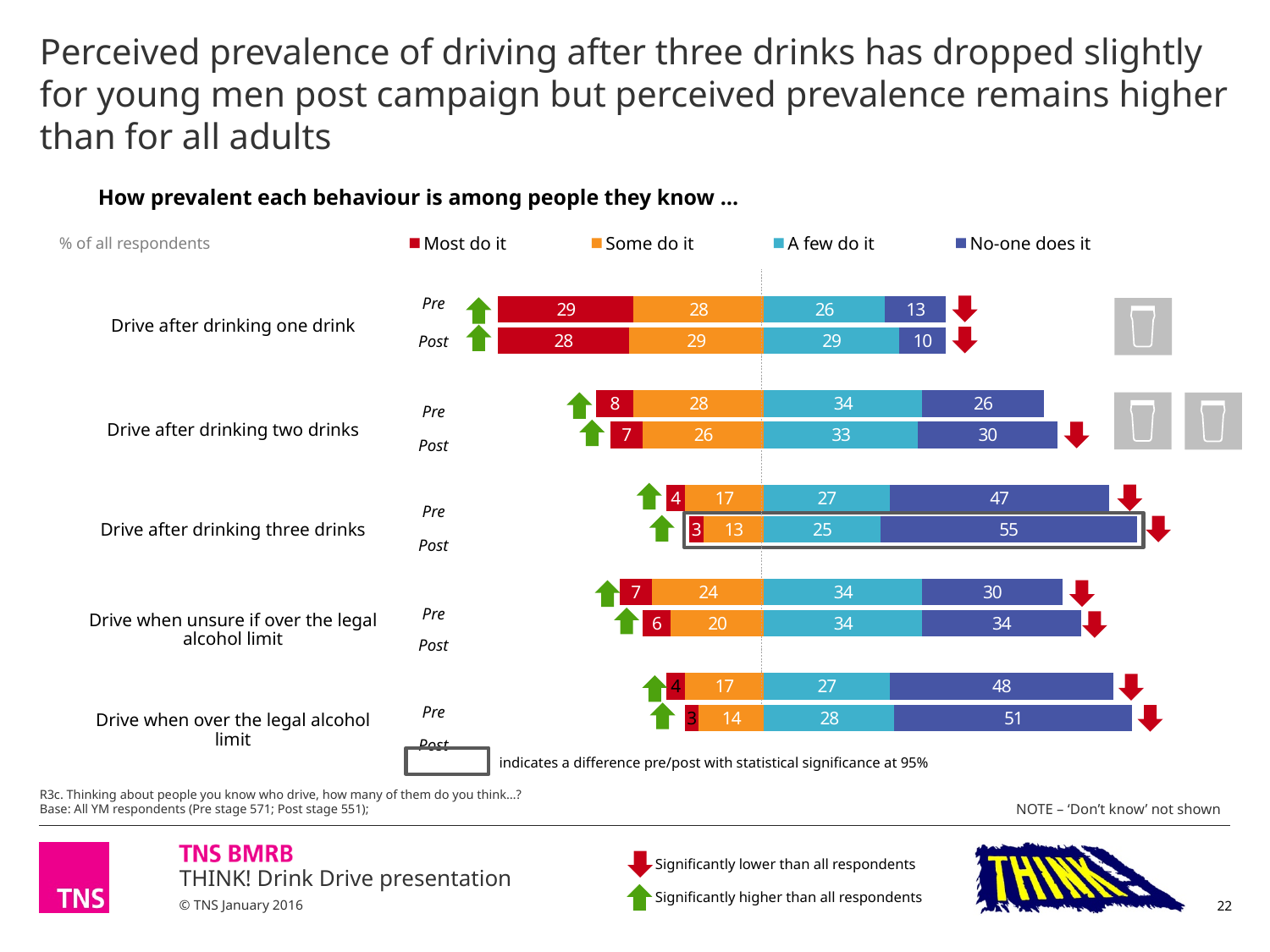
Which is larger: the Post 'No-one does it' value for 'Drive when over the legal alcohol limit' or for 'Drive when unsure if over the legal alcohol limit'? Drive when over the legal alcohol limit How many behaviours are listed on the chart? 5 What is the 'Most do it' value for 'Drive after drinking one drink' in the Pre bar? 29 What is the total of the Post stacked bar for 'Drive after drinking two drinks'? 96 What is the 'No-one does it' value for 'Drive after drinking three drinks' in the Post bar? 55 What is the 'A few do it' value for 'Drive after drinking two drinks' in the Pre bar? 34 What kind of chart is shown on the slide? Stacked bar chart Which behaviour has the lowest 'No-one does it' value in the Post bars? Drive after drinking one drink What is the difference between the Pre and Post 'No-one does it' values for 'Drive after drinking three drinks'? 8 What is the 'Some do it' value for 'Drive when unsure if over the legal alcohol limit' in the Post bar? 20 Which behaviour has the highest 'Most do it' value in the Pre bars? Drive after drinking one drink How many series does the legend list? 4